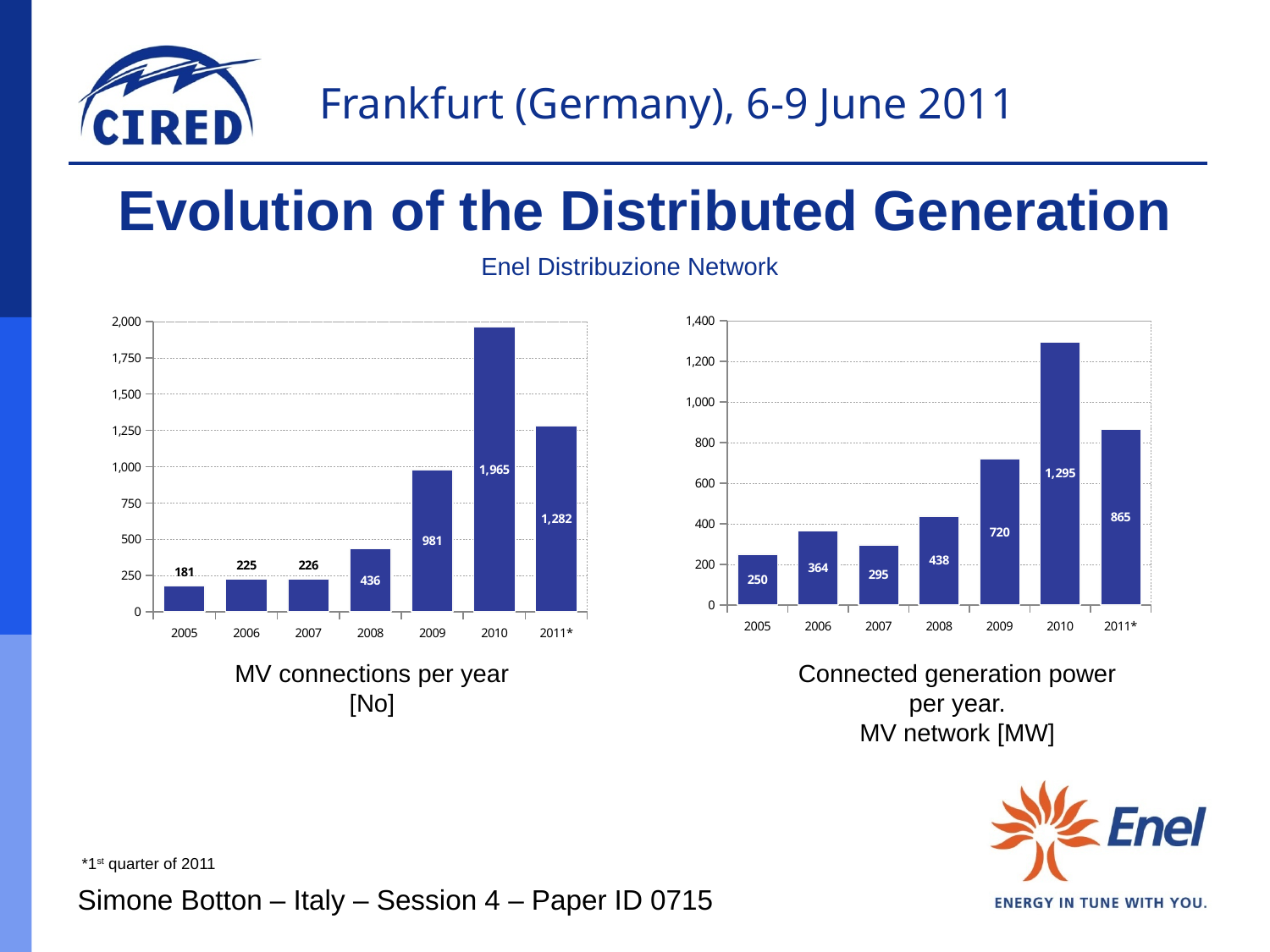
In the 'Connected generation power per year. MV network [MW]' chart, which is larger, the value for 2006 or the value for 2007? 2006 In the 'Connected generation power per year. MV network [MW]' chart, what is the difference between the values for 2010 and 2011*? 430 How many years are shown on the x axis of the 'MV connections per year [No]' chart? 7 In the 'MV connections per year [No]' chart, what is the difference between the values for 2010 and 2009? 984 In the 'MV connections per year [No]' chart, is the value for 2011* greater or less than 1,250? greater What kind of chart is the 'Connected generation power per year. MV network [MW]' chart? bar chart In the 'MV connections per year [No]' chart, what is the value for 2010? 1,965 In the 'Connected generation power per year. MV network [MW]' chart, what is the value for 2011*? 865 In the 'Connected generation power per year. MV network [MW]' chart, which year has the lowest value? 2005 In the 'MV connections per year [No]' chart, what is the value for 2008? 436 In the 'Connected generation power per year. MV network [MW]' chart, what is the value for 2009? 720 In the 'MV connections per year [No]' chart, which year has the highest value? 2010